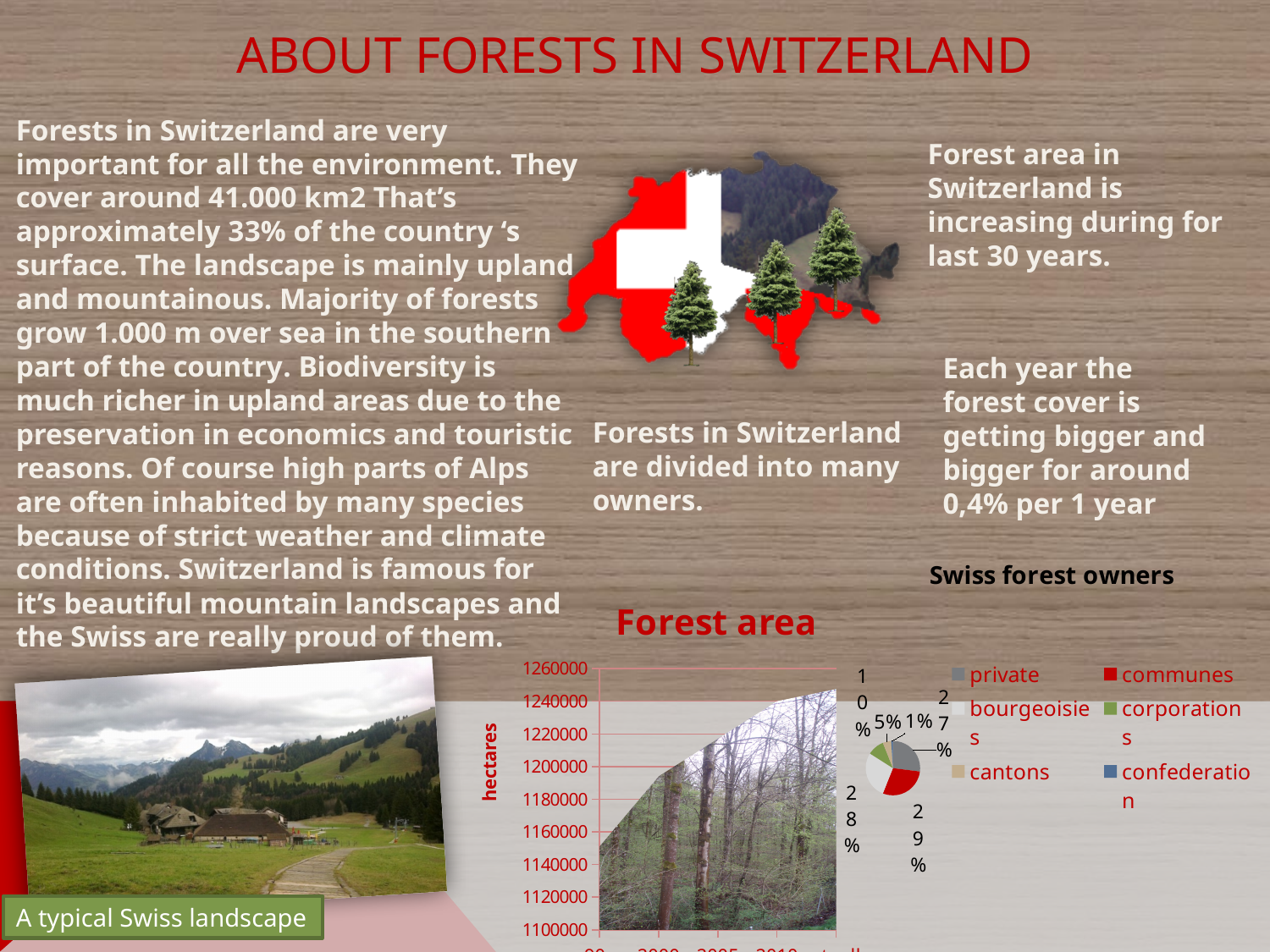
What is the title of the pie chart on the slide? Swiss forest owners What is the highest tick value on the vertical axis of the Forest area chart? 1260000 On the Swiss forest owners pie chart, what is the difference between the 29% slice and the 27% slice? 2% What is the lowest tick value on the vertical axis of the Forest area chart? 1100000 What is the smallest percentage label shown on the Swiss forest owners pie chart? 1% What is the label on the vertical axis of the Forest area chart? hectares Which legend entry of the Swiss forest owners chart is shown in red? communes On the Swiss forest owners pie chart, what is the difference between the 10% slice and the 5% slice? 5% How many owner categories does the legend of the Swiss forest owners chart list? 6 What is the largest percentage label shown on the Swiss forest owners pie chart? 29% What kind of chart is the Swiss forest owners chart? pie chart